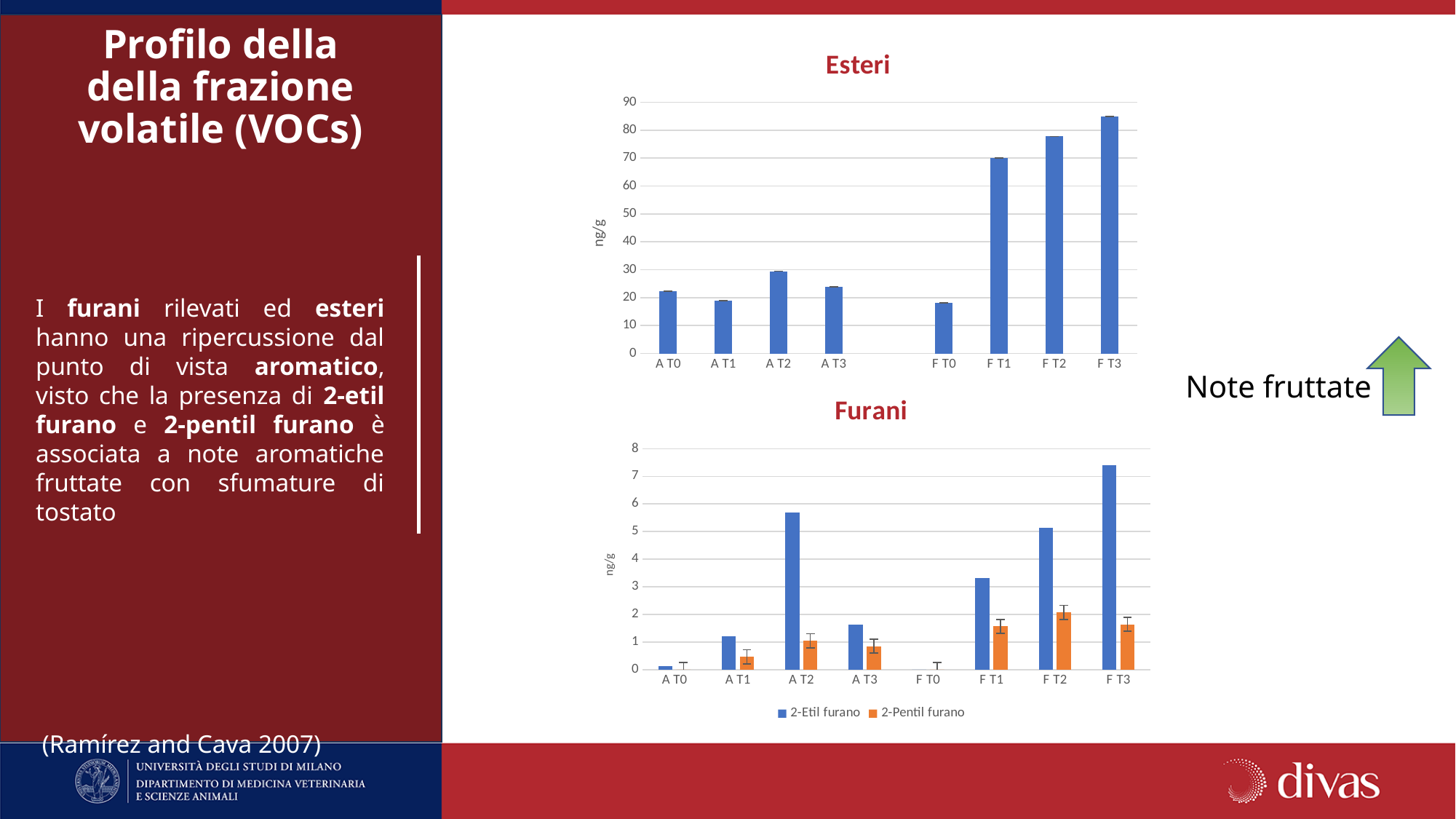
How many series does the legend of the 'Furani' chart list? 2 In the 'Furani' chart, which colour represents 2-Pentil furano? orange In the 'Furani' chart, which category has the highest value for 2-Pentil furano? F T2 What type of chart is the 'Esteri' chart? bar chart In the 'Esteri' chart, is the value for A T1 greater or less than 30? less In the 'Esteri' chart, which category has the highest value? F T3 In the 'Esteri' chart, is the value for F T1 greater or less than 60? greater In the 'Furani' chart, which category has the highest value for 2-Etil furano? F T3 In the 'Esteri' chart, which is larger, the value for A T2 or the value for F T2? F T2 How many categories are shown on the x axis of the 'Esteri' chart? 8 In the 'Esteri' chart, is the value for F T3 greater or less than 80? greater